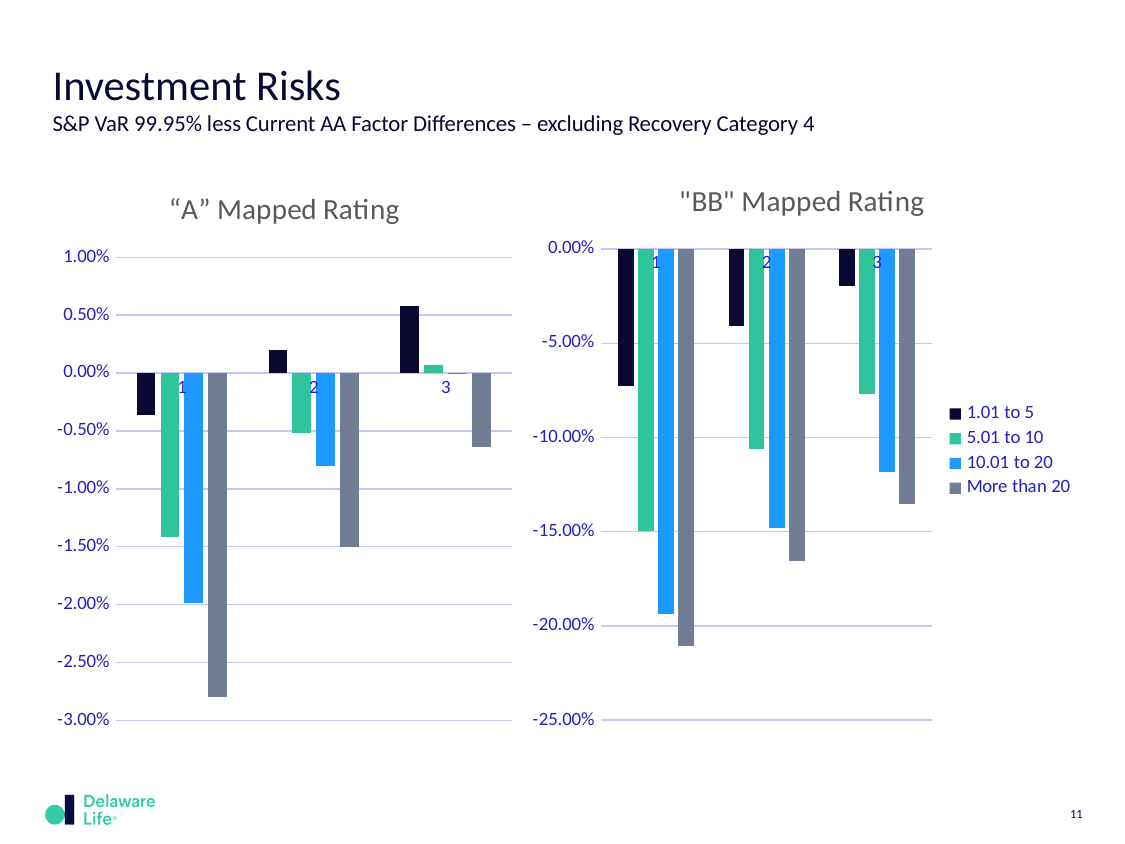
In the "BB" Mapped Rating chart, is the value for More than 20 at category 1 greater or less than -20.00%? less What kind of chart is the "A" Mapped Rating chart? bar chart In the "A" Mapped Rating chart, which series has the lowest value at category 1? More than 20 How many categories are shown on the x axis of the "BB" Mapped Rating chart? 3 In the "BB" Mapped Rating chart, is the value for More than 20 at category 3 greater or less than -15.00%? greater How many series does the legend list for the charts? 4 In the "A" Mapped Rating chart, which series has the highest value at category 3? 1.01 to 5 In the "BB" Mapped Rating chart, which series has the lowest value at category 1? More than 20 In the "A" Mapped Rating chart, is the value for More than 20 at category 1 greater or less than -2.50%? less In the "A" Mapped Rating chart, which is larger at category 3: the value for 1.01 to 5 or the value for More than 20? 1.01 to 5 In the "BB" Mapped Rating chart, do the values for the More than 20 series rise or fall from category 1 to category 3? rise